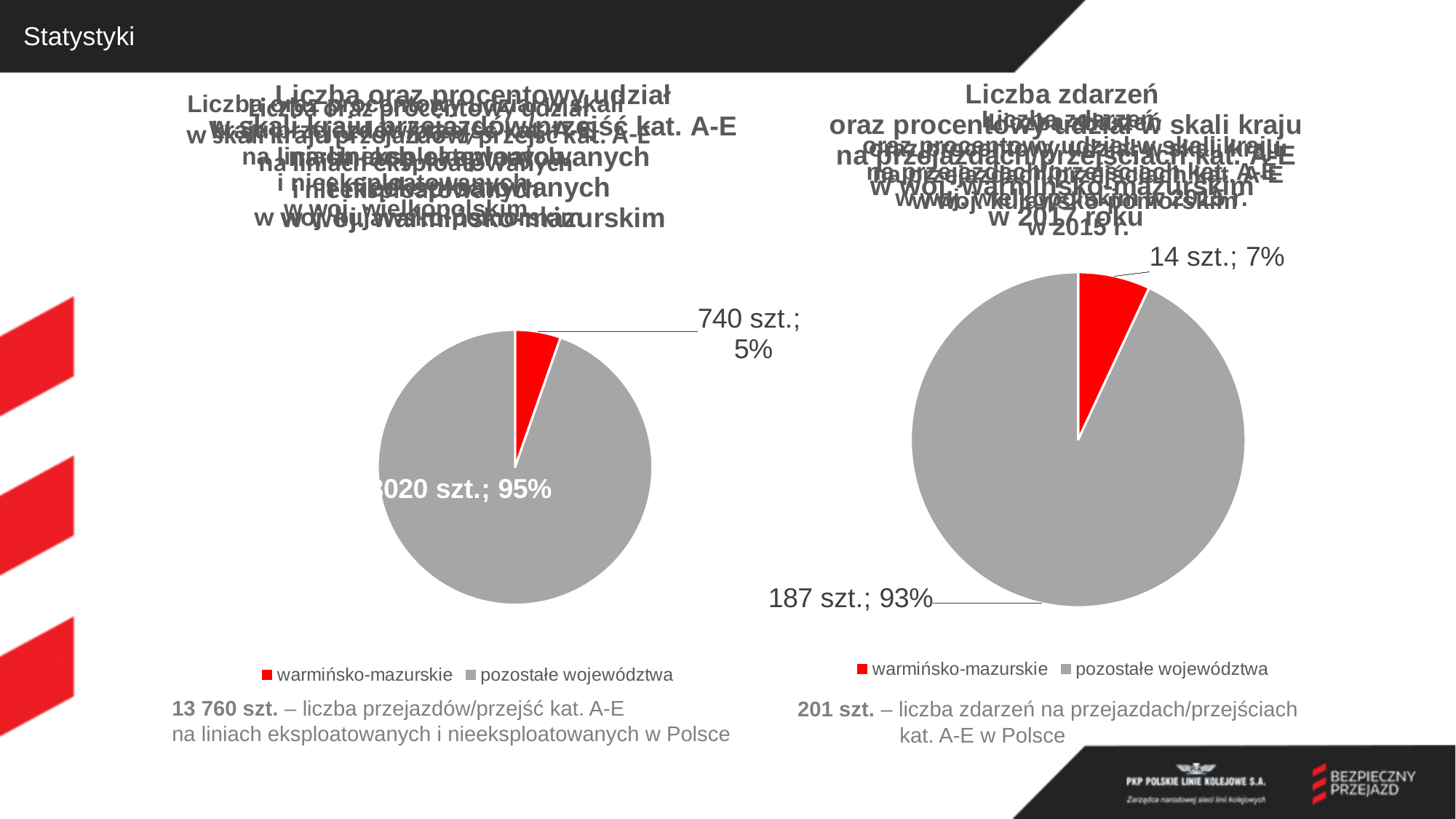
On the left pie chart, what share of the pie does pozostałe województwa have? 95% On the right pie chart, what is the total count of the two slices? 201 szt. On the left pie chart, what colour is the warmińsko-mazurskie slice? Red How many slices does the right pie chart have? 2 What kind of chart is the left chart? Pie chart On the left pie chart, what share of the pie does warmińsko-mazurskie have? 5% On the right pie chart, what is the difference in count between pozostałe województwa and warmińsko-mazurskie? 173 szt. How many entries does the legend of the left chart list? 2 On the left pie chart, what value is shown for warmińsko-mazurskie? 740 szt.; 5% On the right pie chart, what value is shown for warmińsko-mazurskie? 14 szt.; 7% On the right pie chart, which slice is larger: warmińsko-mazurskie or pozostałe województwa? pozostałe województwa On the right pie chart, what value is shown for pozostałe województwa? 187 szt.; 93%